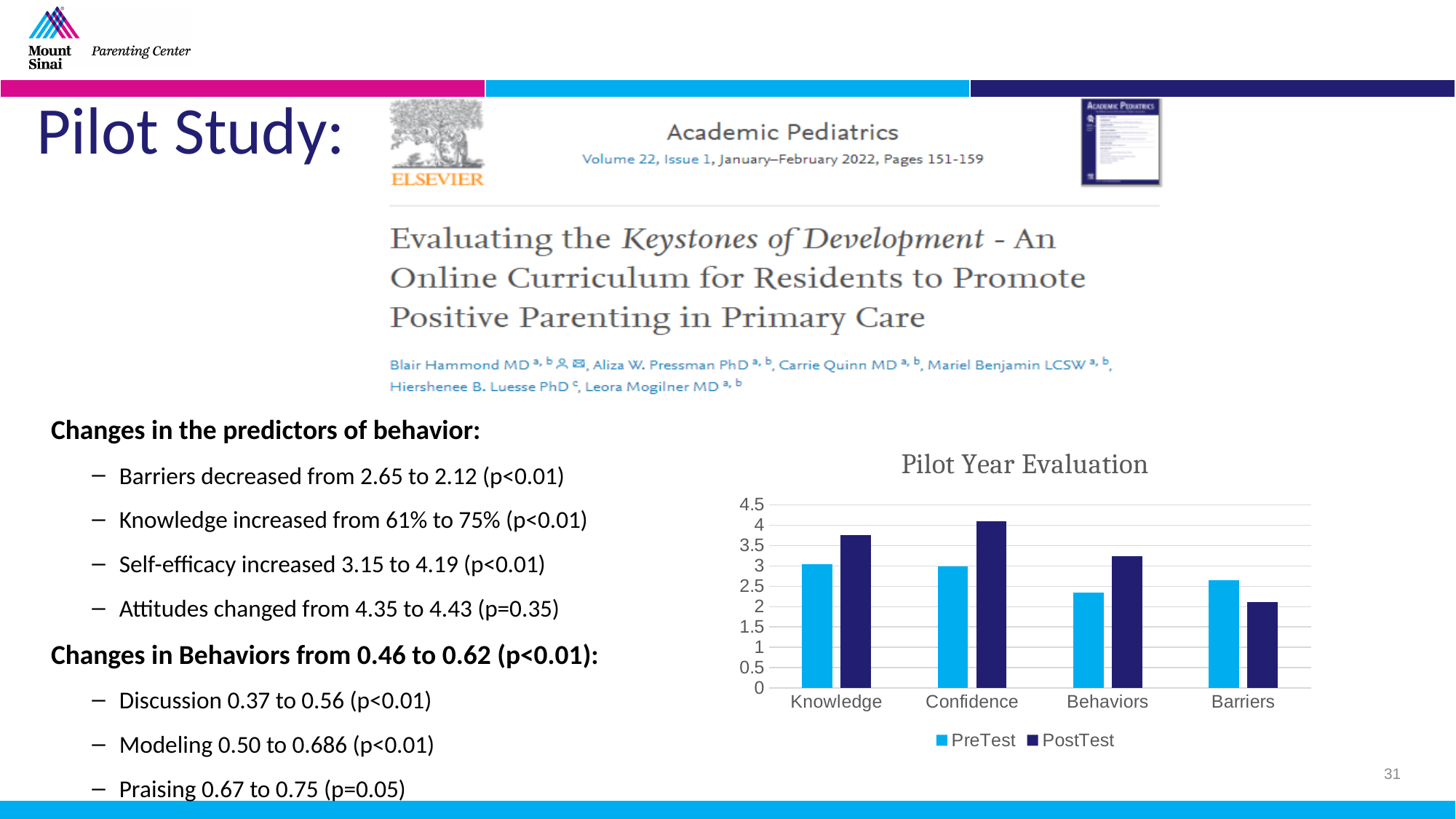
In the Pilot Year Evaluation chart, is the PreTest or the PostTest bar larger for Barriers? PreTest Which category has the lowest PreTest bar in the Pilot Year Evaluation chart? Behaviors In the Pilot Year Evaluation chart, is the PostTest value for Knowledge greater or less than 3.5? greater Which category has the highest PostTest bar in the Pilot Year Evaluation chart? Confidence In the Pilot Year Evaluation chart, is the PostTest value for Barriers greater or less than 2.5? less How many series does the legend of the Pilot Year Evaluation chart list? 2 What type of chart is shown under the title "Pilot Year Evaluation"? bar chart What is the title of the chart on the slide? Pilot Year Evaluation How many categories are shown on the x axis of the Pilot Year Evaluation chart? 4 In the Pilot Year Evaluation chart, which is larger: the PostTest value for Knowledge or the PostTest value for Behaviors? Knowledge Which category has the lowest PostTest bar in the Pilot Year Evaluation chart? Barriers In the Pilot Year Evaluation chart, is the PreTest value for Behaviors greater or less than 2.5? less